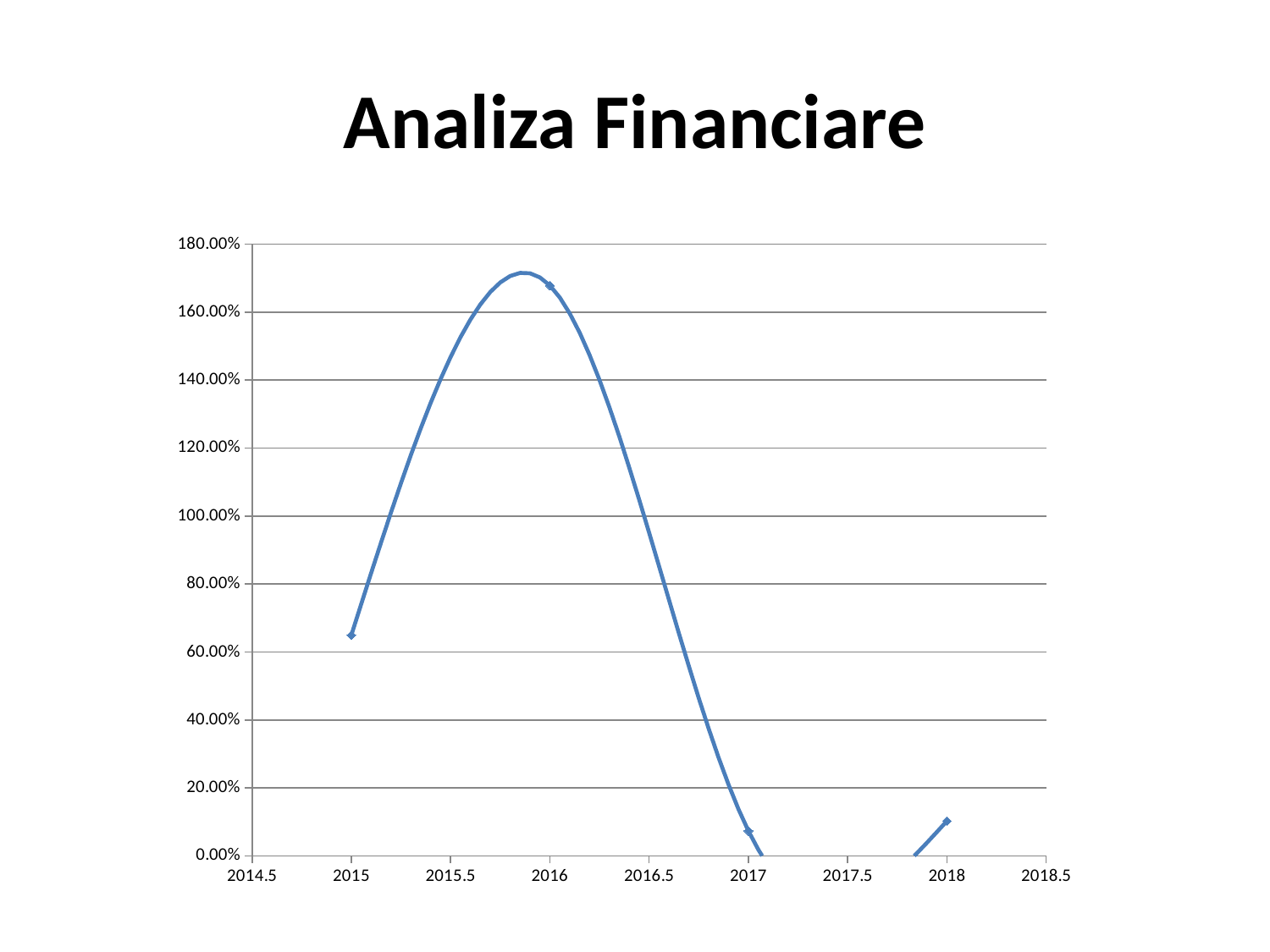
What is the highest value shown on the vertical axis? 180.00% What is the title of the chart on the slide? Analiza Financiare Is the value for 2018 greater or less than 20.00%? less What kind of chart is shown on the slide? line chart Which is larger, the value for 2015 or the value for 2016? 2016 Which year has the highest value on the chart? 2016 Does the value rise or fall from 2016 to 2017? fall How many data points are plotted on the chart? 4 Is the value for 2016 greater or less than 160.00%? greater Is the value for 2017 greater or less than 20.00%? less Which is larger, the value for 2015 or the value for 2017? 2015